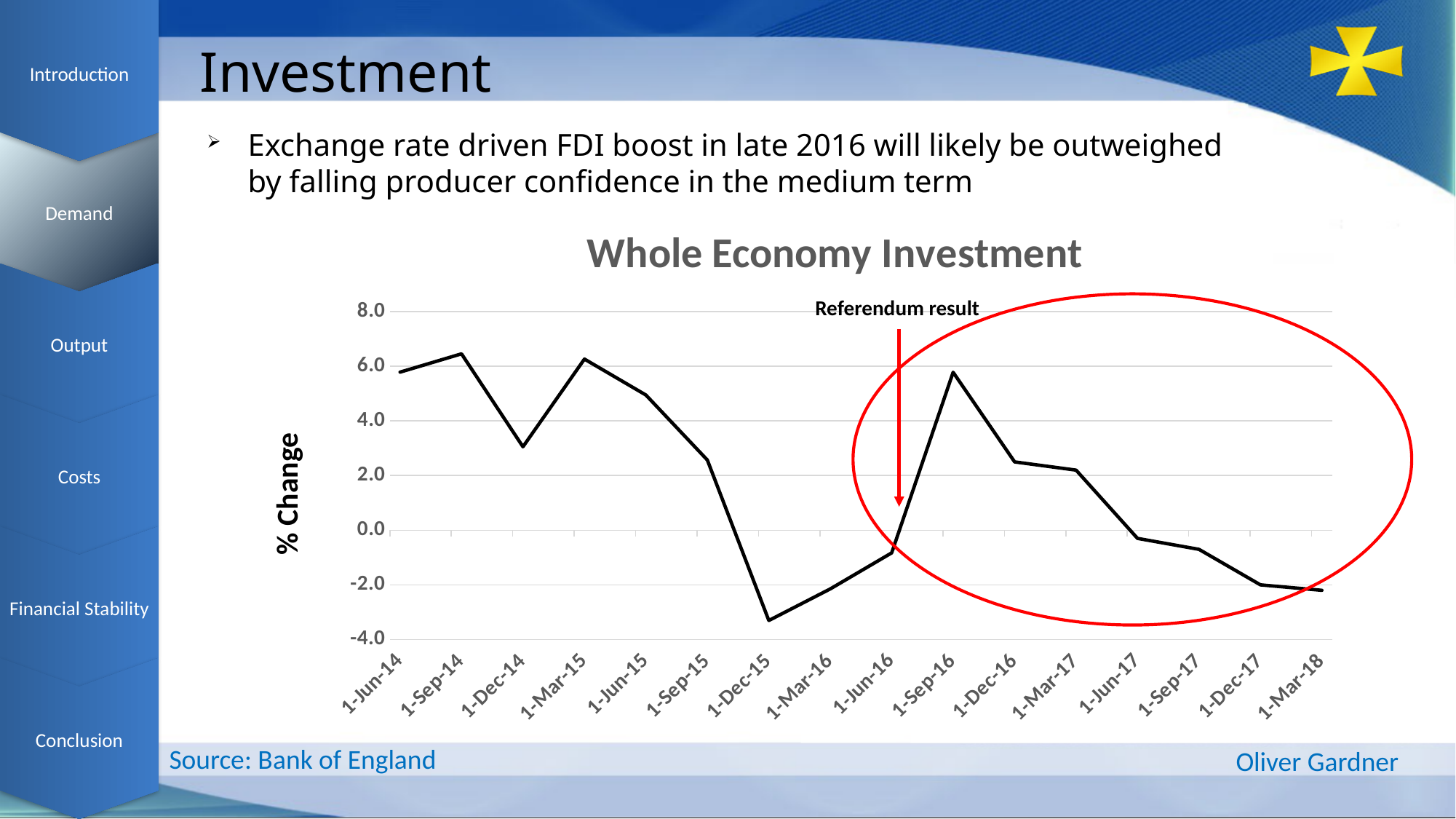
What is the title of the chart? Whole Economy Investment Is the value for 1-Sep-16 greater or less than 4.0? greater At which date does the line reach its lowest value? 1-Dec-15 Which has the higher value, 1-Sep-16 or 1-Dec-16? 1-Sep-16 What kind of chart is shown on the slide? line chart Which has the higher value, 1-Jun-14 or 1-Dec-14? 1-Jun-14 Is the value for 1-Dec-14 greater or less than 4.0? less Is the value for 1-Mar-18 greater or less than 0.0? less Does the line rise or fall from 1-Sep-16 to 1-Mar-18? fall What event does the red arrow annotation on the chart mark? Referendum result How many dates are labelled along the x axis of the chart? 16